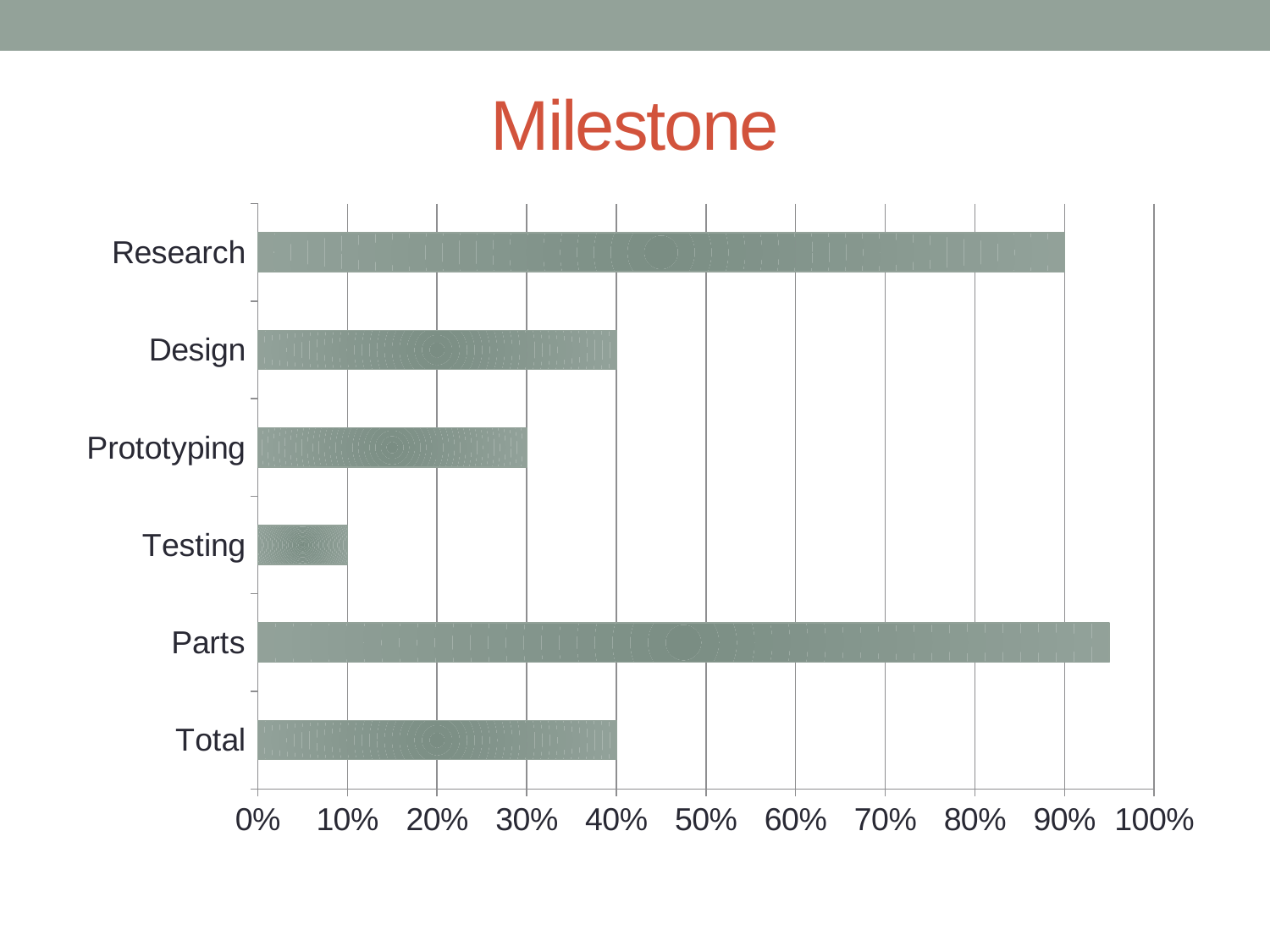
What is the value for Research? 90% What is the value for Testing? 10% Which is larger, the value for Design or the value for Prototyping? Design Is the value for Parts greater or less than 90%? greater What kind of chart is shown on the slide? Bar chart Which category has the highest value? Parts What is the value for Prototyping? 30% How many categories are shown in the chart? 6 What is the difference between the values for Research and Design? 50% What is the value for Design? 40% Which category has the lowest value? Testing What is the value for Total? 40%